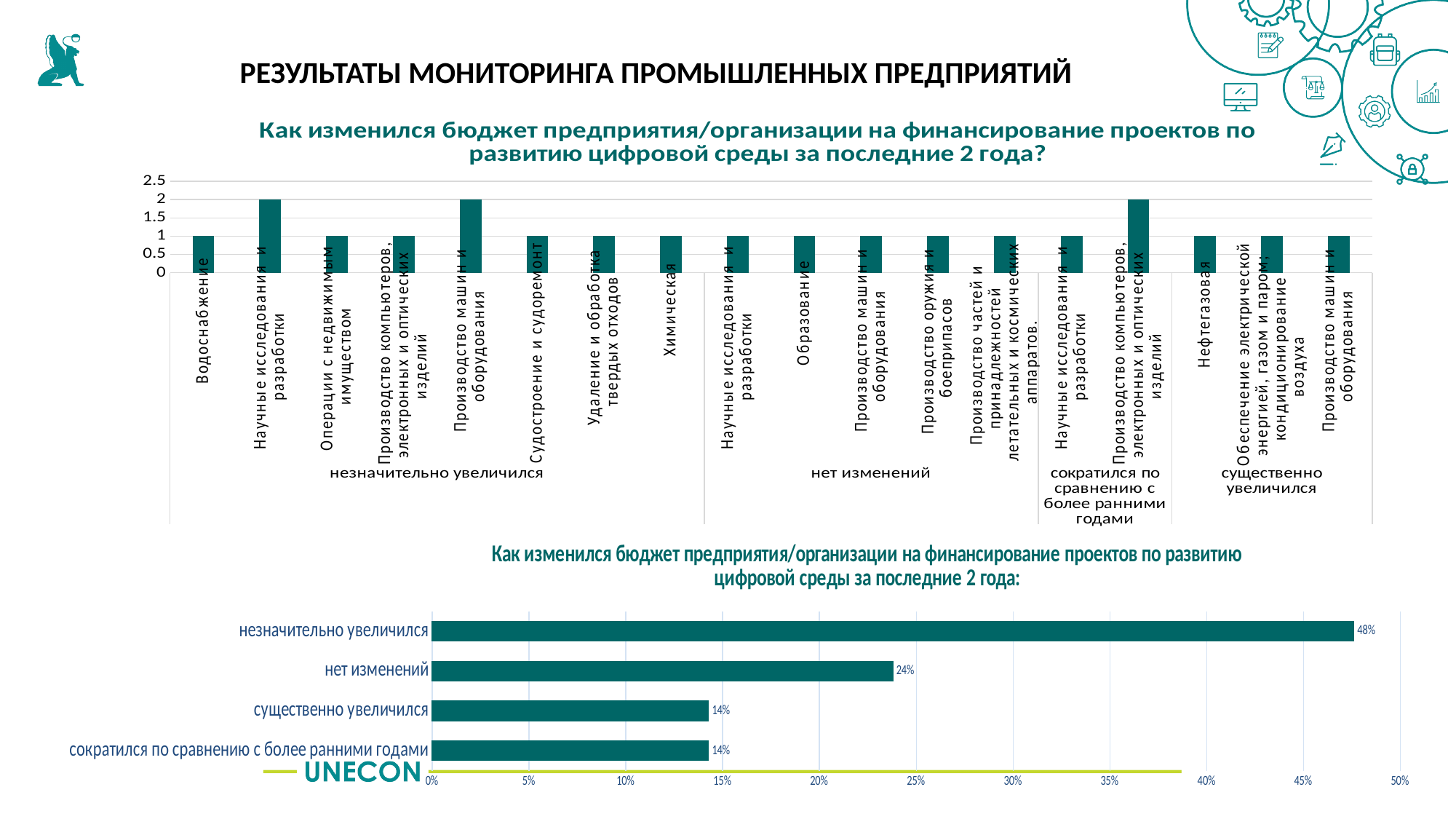
In the bottom chart, what is the value for "нет изменений"? 24% In the top chart, how many bars are in the "нет изменений" group? 5 In the bottom chart, how many answer options are shown? 4 In the top chart, which is larger: "Научные исследования и разработки" in the "незначительно увеличился" group or "Образование" in the "нет изменений" group? Научные исследования и разработки What type of chart is the bottom chart? bar chart In the bottom chart, which answer option has the highest share? незначительно увеличился In the bottom chart, is the value for "существенно увеличился" greater or less than 15%? less In the top chart, what is the value for "Производство компьютеров, электронных и оптических изделий" in the "сократился по сравнению с более ранними годами" group? 2 In the top chart, what is the value for "Водоснабжение" in the "незначительно увеличился" group? 1 In the top chart, what is the maximum value shown on the vertical axis? 2.5 In the bottom chart, what percentage of respondents answered "незначительно увеличился"? 48% In the bottom chart, what is the difference between "незначительно увеличился" and "нет изменений"? 24%